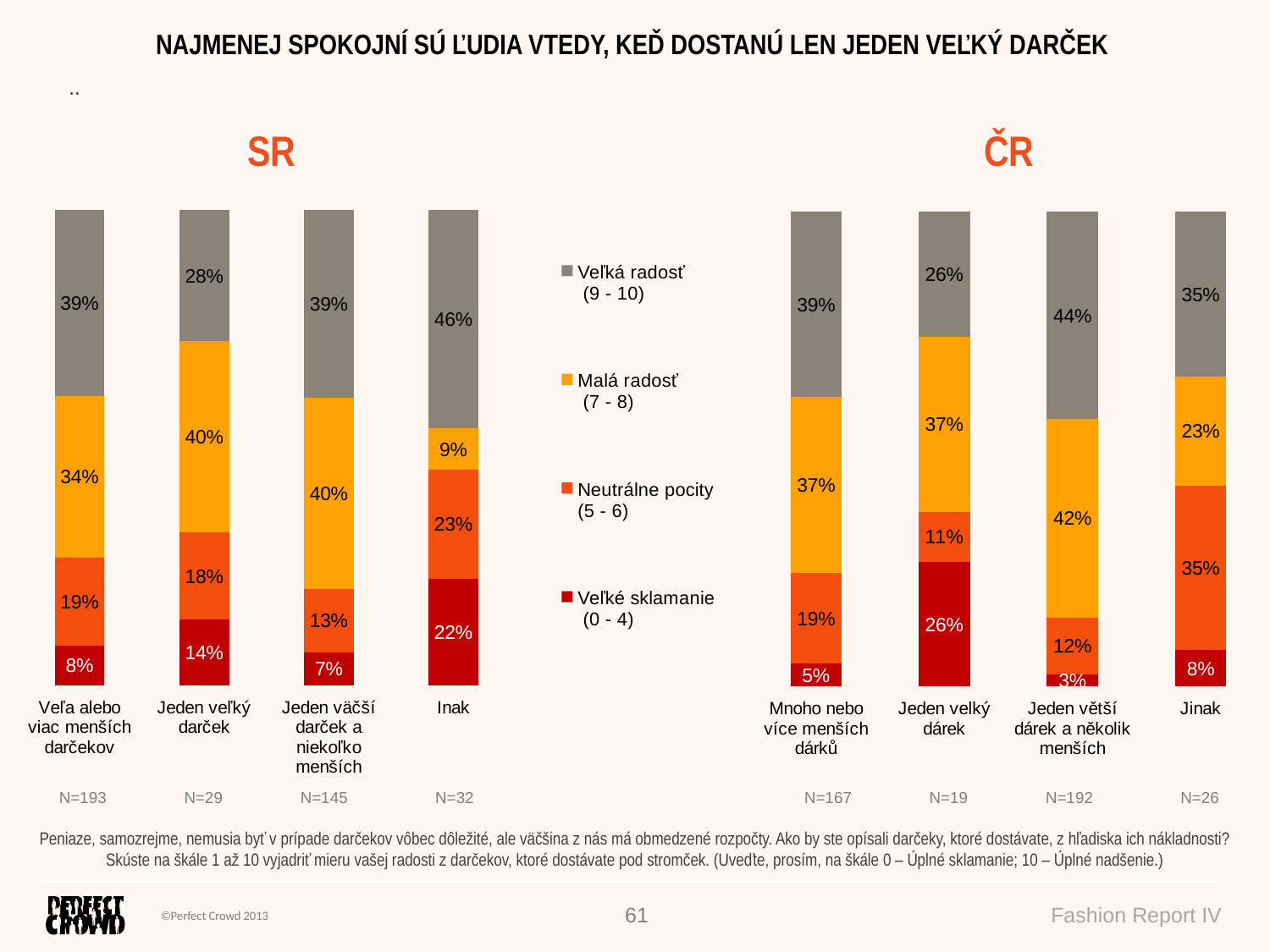
In the ČR chart, what is the value of Veľká radosť (9 - 10) for Jeden větší dárek a několik menších? 44% In the ČR chart, which category has the highest value for Veľké sklamanie (0 - 4)? Jeden velký dárek What type of chart is used for the SR data? Stacked bar chart In the SR chart, what is the value of Neutrálne pocity (5 - 6) for Inak? 23% How many series does the legend list? 4 What is the sample size (N) shown for the Inak category in the SR chart? N=32 How many categories are shown in the ČR chart? 4 In the ČR chart, what is the value of Veľké sklamanie (0 - 4) for Mnoho nebo více menších dárků? 5% In the SR chart, what is the value of Veľké sklamanie (0 - 4) for Jeden veľký darček? 14% In the ČR chart, which is larger: Malá radosť (7 - 8) for Jeden větší dárek a několik menších or for Jinak? Jeden větší dárek a několik menších In the SR chart, what is the difference between the Veľká radosť (9 - 10) values for Inak and Jeden veľký darček? 18% In the SR chart, which category has the lowest value for Malá radosť (7 - 8)? Inak